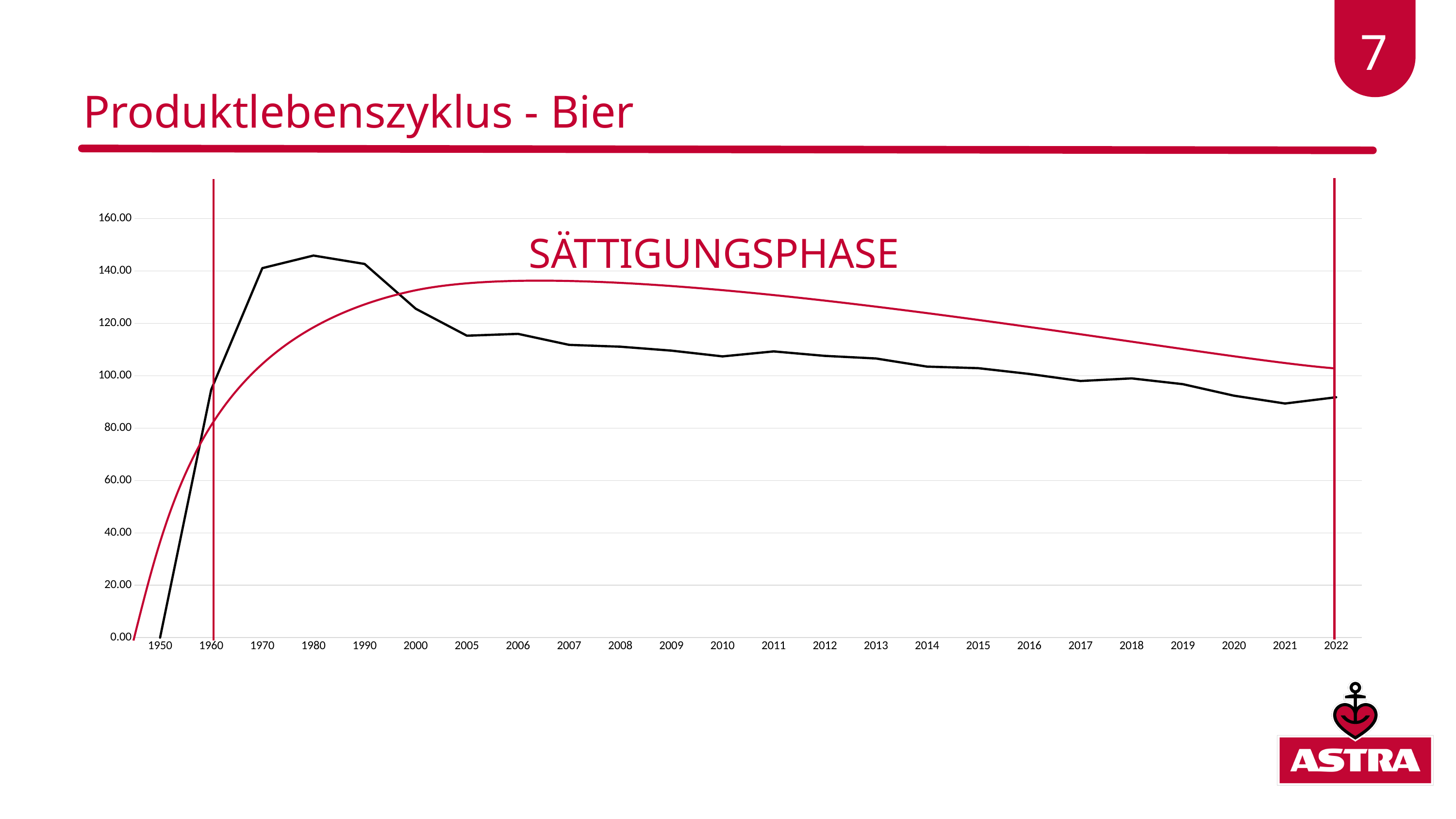
Is the value of the black line for 1980 greater or less than 140? greater Is the value of the black line for 2021 greater or less than 100? less Is the value of the black line for 2000 greater or less than 120? greater In which year does the black line reach its highest value? 1980 What kind of chart is shown on the slide? line chart What phase label is written in red above the chart? SÄTTIGUNGSPHASE What is the title of the slide containing the chart? Produktlebenszyklus - Bier Does the black line generally rise or fall from 1990 to 2022? fall Which year has the larger value on the black line, 2000 or 2010? 2000 How many year labels are shown on the x axis of the chart? 24 In which year does the black line have its lowest value? 1950